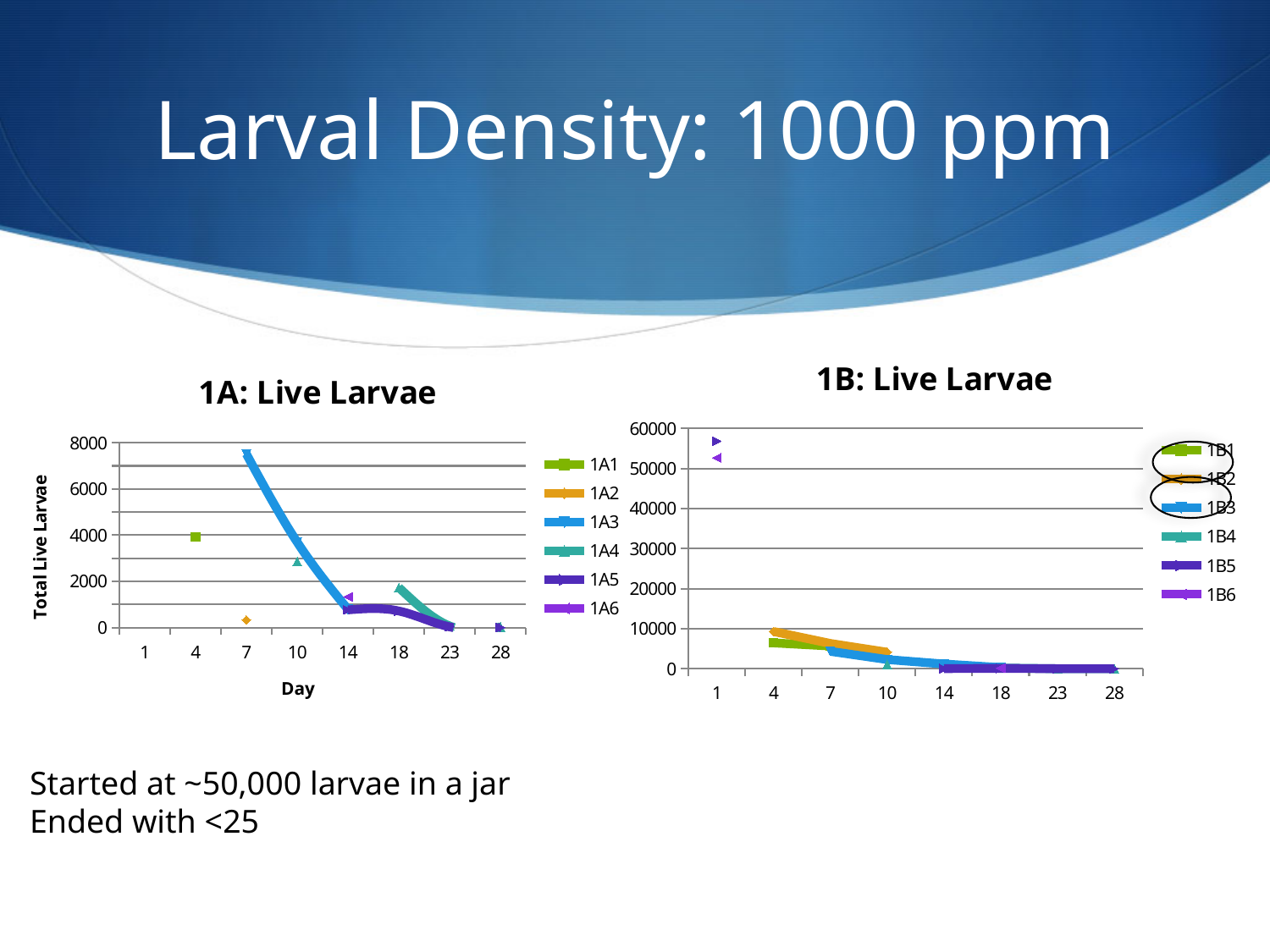
In the "1B: Live Larvae" chart, is the highest point plotted on day 1 greater or less than 50000? greater In the "1B: Live Larvae" chart, does the 1B2 series rise or fall from day 4 to day 10? fall How many series does the legend of the "1A: Live Larvae" chart list? 6 In the "1A: Live Larvae" chart, is the value for 1A3 on day 7 greater or less than 6000? greater In the "1A: Live Larvae" chart, does the 1A3 series rise or fall from day 7 to day 14? fall How many series does the legend of the "1B: Live Larvae" chart list? 6 In the "1A: Live Larvae" chart, which series reaches the highest value? 1A3 What kind of chart is the "1A: Live Larvae" chart? line chart How many day values are shown on the x axis of the "1A: Live Larvae" chart? 8 In the "1A: Live Larvae" chart, is the value for 1A1 on day 4 greater or less than 2000? greater What is the y-axis title of the "1A: Live Larvae" chart? Total Live Larvae